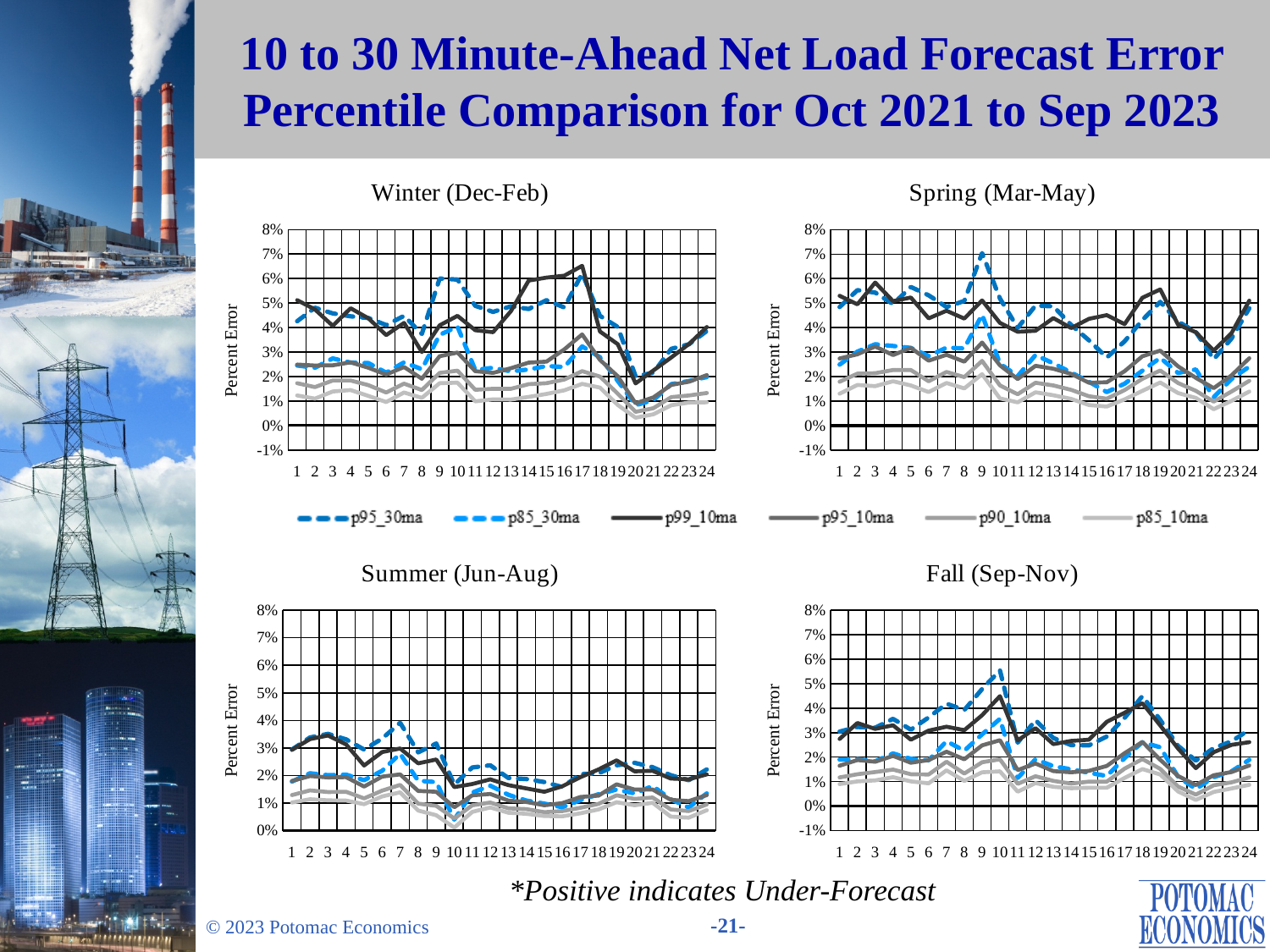
In the Winter (Dec-Feb) chart, is the value of p85_10ma at hour 20 greater or less than 1%? less How many series does the legend list? 6 In the Winter (Dec-Feb) chart, does p99_10ma rise or fall from hour 17 to hour 20? fall In the Summer (Jun-Aug) chart, how many hours are shown along the x axis? 24 What is the label on the y axis of the Fall (Sep-Nov) chart? Percent Error In the Winter (Dec-Feb) chart, is the value of p99_10ma larger at hour 17 or at hour 20? hour 17 In the Winter (Dec-Feb) chart, is the value of p99_10ma at hour 17 greater or less than 6%? greater In the Spring (Mar-May) chart, at which hour does p95_30ma reach its highest value? 9 In the Spring (Mar-May) chart, is the value of p95_30ma at hour 9 greater or less than 6%? greater What kind of chart is the Winter (Dec-Feb) chart? line chart How many charts are shown on the slide? 4